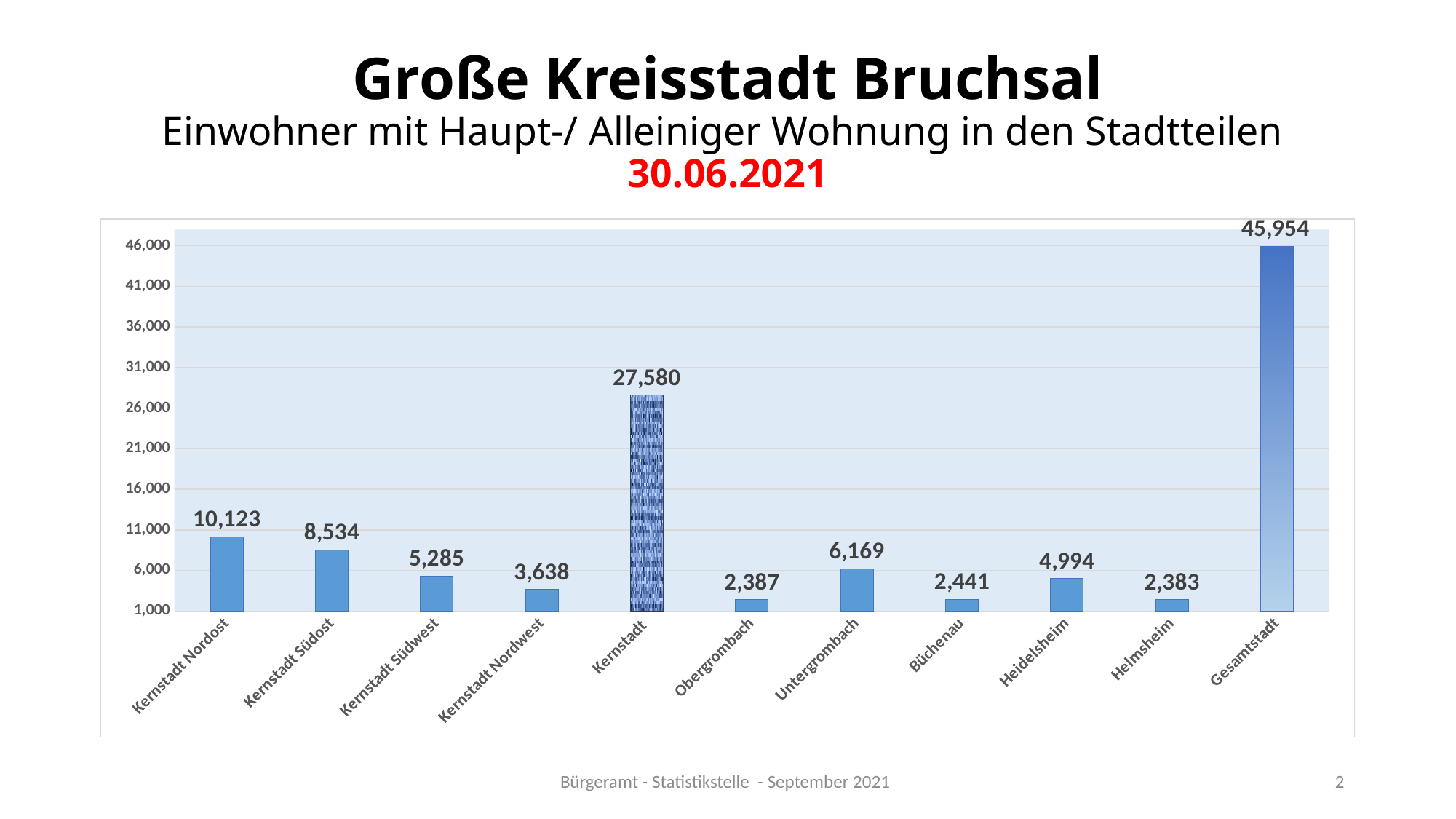
What is the value for Gesamtstadt? 45,954 What is the value for Kernstadt Nordost? 10,123 What is the value for Kernstadt? 27,580 Which category has the lowest value? Helmsheim Which category has the highest value? Gesamtstadt Is the value for Kernstadt greater or less than 26,000? greater Which is larger, Heidelsheim or Kernstadt Südwest? Kernstadt Südwest What is the value for Untergrombach? 6,169 What date is shown in red below the chart title? 30.06.2021 What is the difference between Kernstadt Nordost and Kernstadt Südost? 1,589 What kind of chart is shown on the slide? bar chart How many categories are shown on the x axis? 11